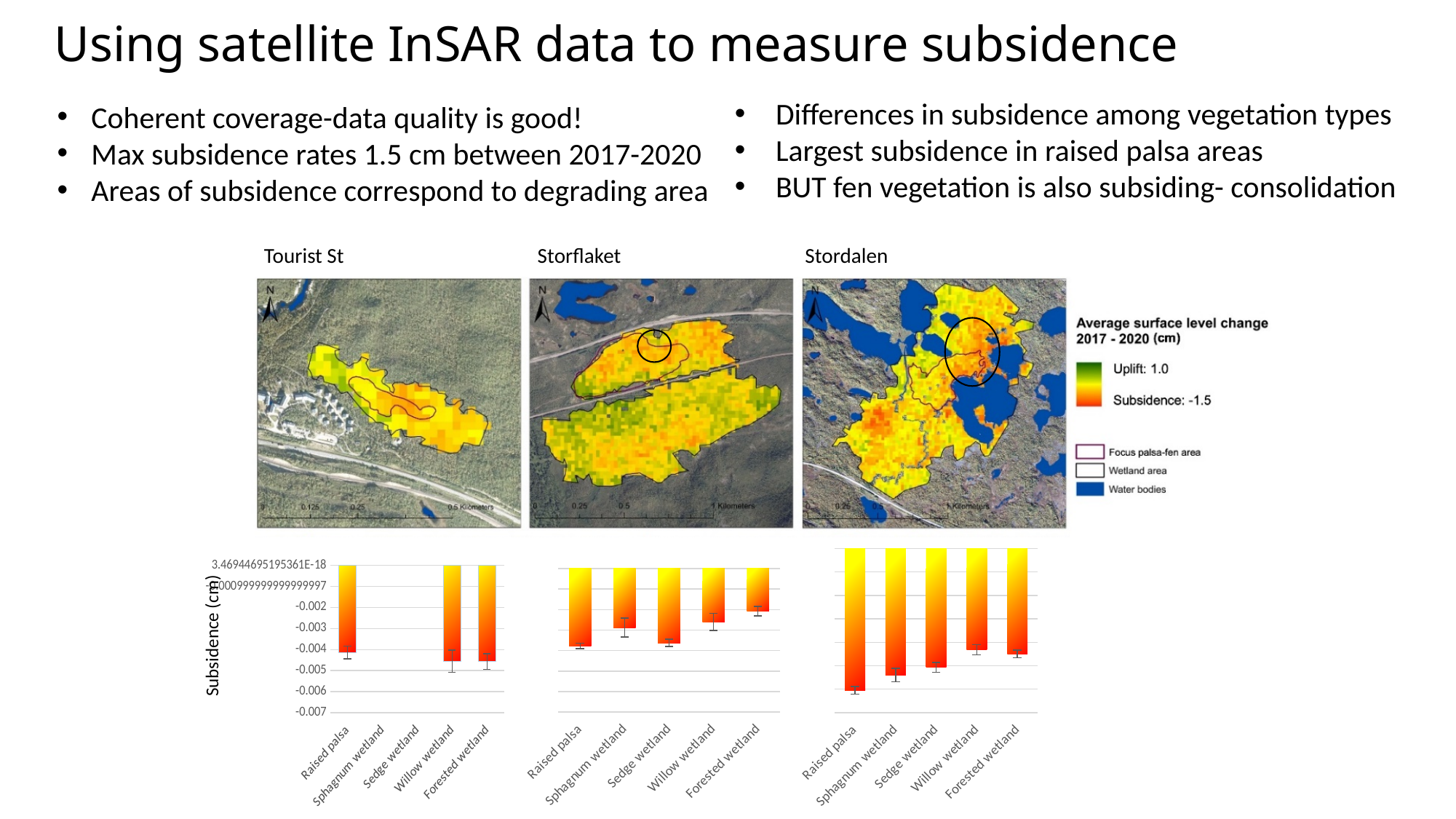
What is the y-axis label shared by the bar charts at the bottom of the slide? Subsidence (cm) What kind of chart is the Tourist St chart at the bottom left of the slide? bar chart In the Storflaket chart, which vegetation type shows the largest subsidence (longest bar)? Raised palsa In the Tourist St chart, is the value for Raised palsa greater or less than -0.003? less How many vegetation categories are listed on the x axis of the Storflaket chart? 5 In the Storflaket chart, which vegetation type shows the smallest subsidence (shortest bar)? Forested wetland In the Tourist St chart, how many categories actually have a bar plotted? 3 In the Stordalen chart, do the bars get shorter or longer moving from Raised palsa to Forested wetland along the x axis? shorter In the Tourist St chart, is the value for Willow wetland greater or less than -0.004? less In the Stordalen chart, which vegetation type shows the largest subsidence (longest bar)? Raised palsa In the Tourist St chart, which two categories have no bar plotted? Sphagnum wetland and Sedge wetland In the Storflaket chart, which has the larger subsidence (longer bar): Sedge wetland or Willow wetland? Sedge wetland